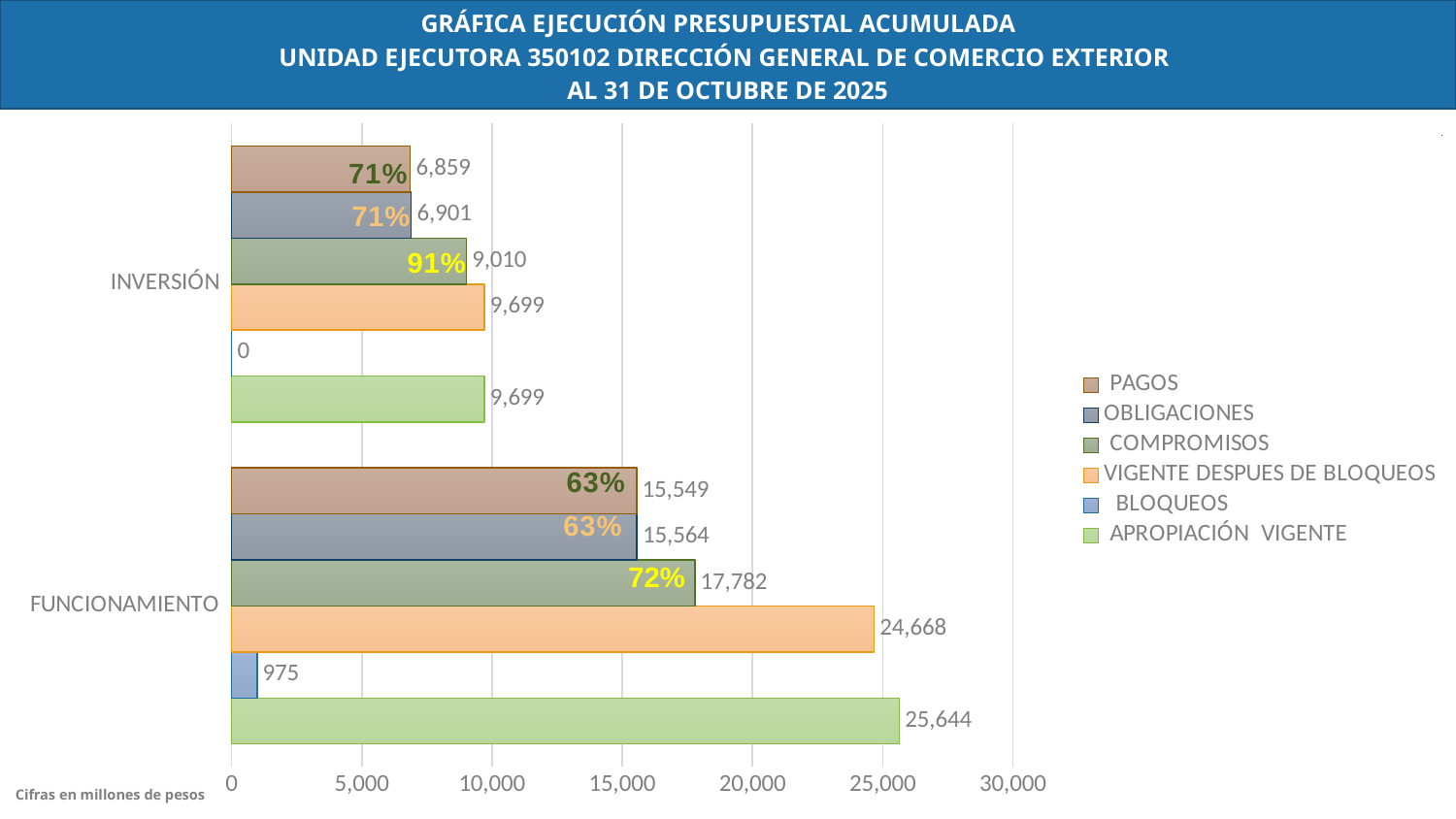
What is the value of COMPROMISOS for INVERSIÓN? 9,010 What is the value of PAGOS for INVERSIÓN? 6,859 Which series has the lowest value for INVERSIÓN? BLOQUEOS What is the difference between APROPIACIÓN VIGENTE and VIGENTE DESPUES DE BLOQUEOS for FUNCIONAMIENTO? 976 How many categories are shown on the vertical axis? 2 What is the value of BLOQUEOS for FUNCIONAMIENTO? 975 What kind of chart is shown on the slide? Bar chart What is the value of APROPIACIÓN VIGENTE for FUNCIONAMIENTO? 25,644 Which is larger: COMPROMISOS for FUNCIONAMIENTO or VIGENTE DESPUES DE BLOQUEOS for INVERSIÓN? COMPROMISOS for FUNCIONAMIENTO What percentage is shown on the COMPROMISOS bar for FUNCIONAMIENTO? 72% How many series does the legend list? 6 Which series has the highest value for FUNCIONAMIENTO? APROPIACIÓN VIGENTE